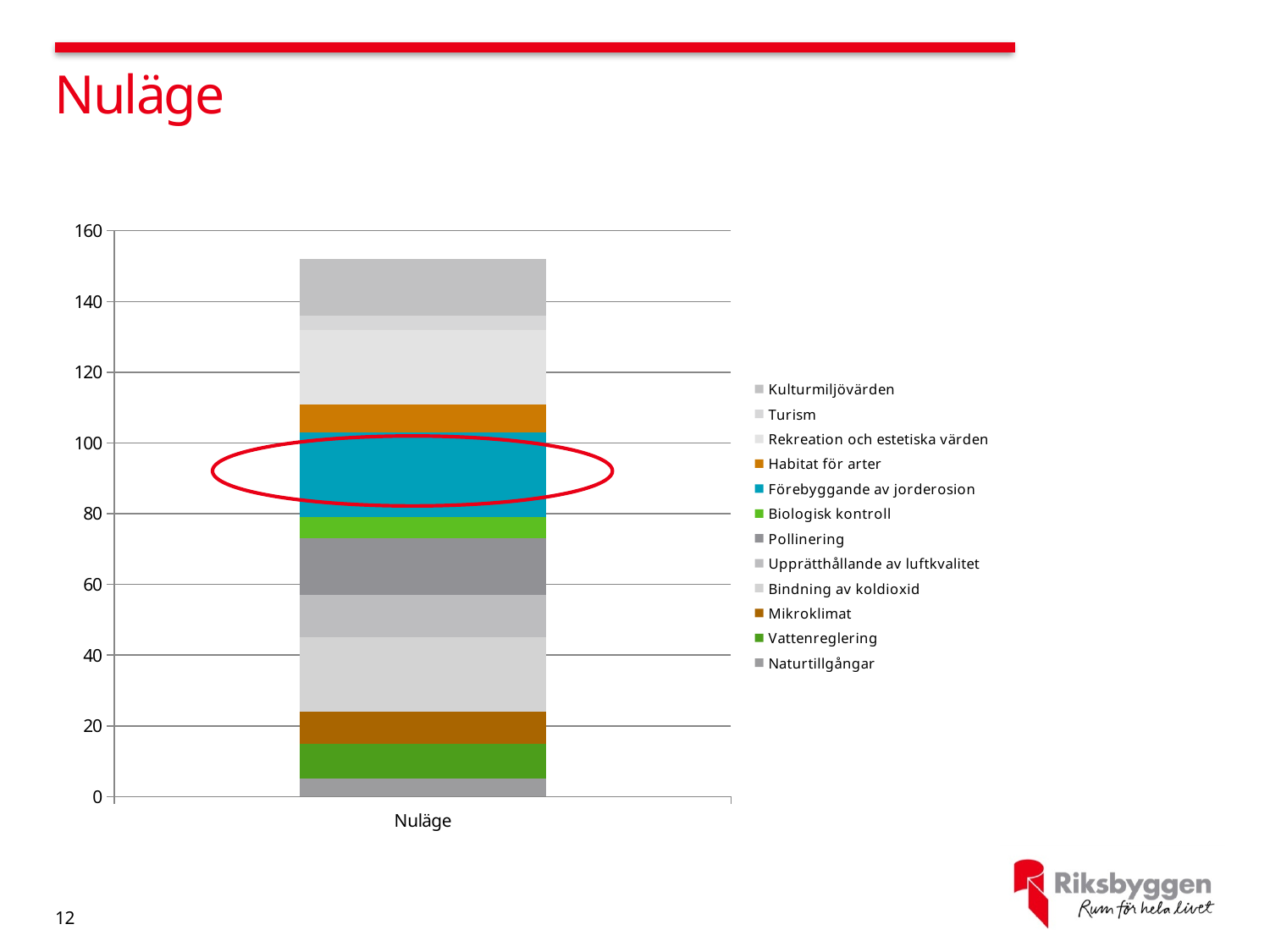
What is the label of the single category on the x axis? Nuläge Is the total height of the Nuläge stacked bar greater or less than 140? greater How many categories are plotted on the x axis? 1 Which series is highlighted with a red ellipse on the chart? Förebyggande av jorderosion What is the highest value shown on the y axis? 160 Which segment is larger in the Nuläge bar: Förebyggande av jorderosion or Turism? Förebyggande av jorderosion How many series does the legend list? 12 Is the total height of the Nuläge stacked bar greater or less than 160? less Which segment is larger in the Nuläge bar: Bindning av koldioxid or Vattenreglering? Bindning av koldioxid Which segment is larger in the Nuläge bar: Pollinering or Turism? Pollinering What kind of chart is shown on the slide? stacked bar chart